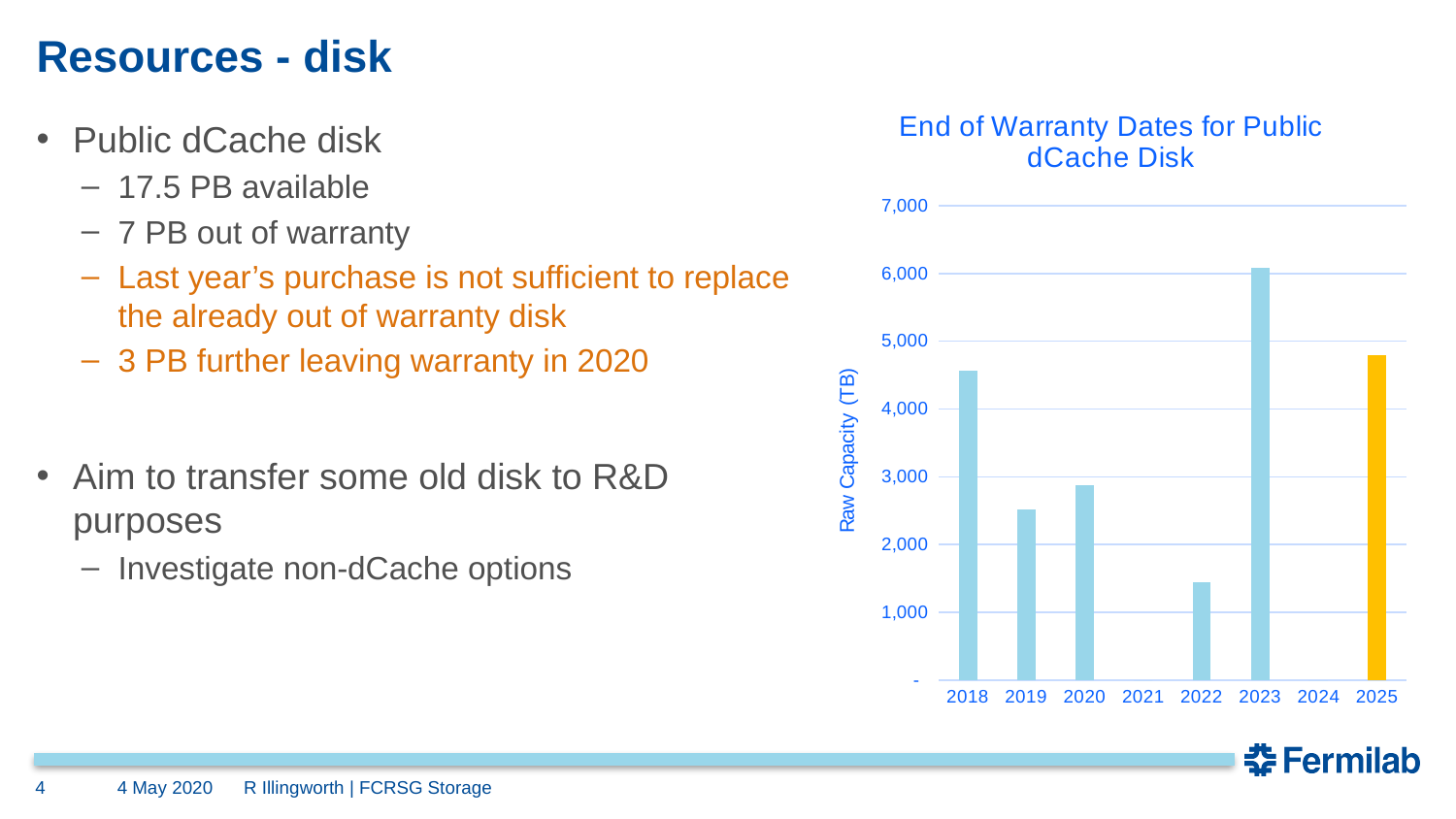
Which year has the highest raw capacity in the chart? 2023 Is the value for 2025 greater or less than 5,000? less Among the years with a bar, which year has the lowest raw capacity? 2022 Which year has the larger raw capacity, 2018 or 2019? 2018 Which year has the larger raw capacity, 2023 or 2025? 2023 What is the title of the chart? End of Warranty Dates for Public dCache Disk Is the value for 2018 greater or less than 4,000? greater Is the value for 2022 greater or less than 2,000? less What kind of chart is shown on the slide? bar chart How many bars are plotted in the chart? 6 How many years are labelled on the x axis of the chart? 8 What is the label on the vertical axis of the chart? Raw Capacity (TB)